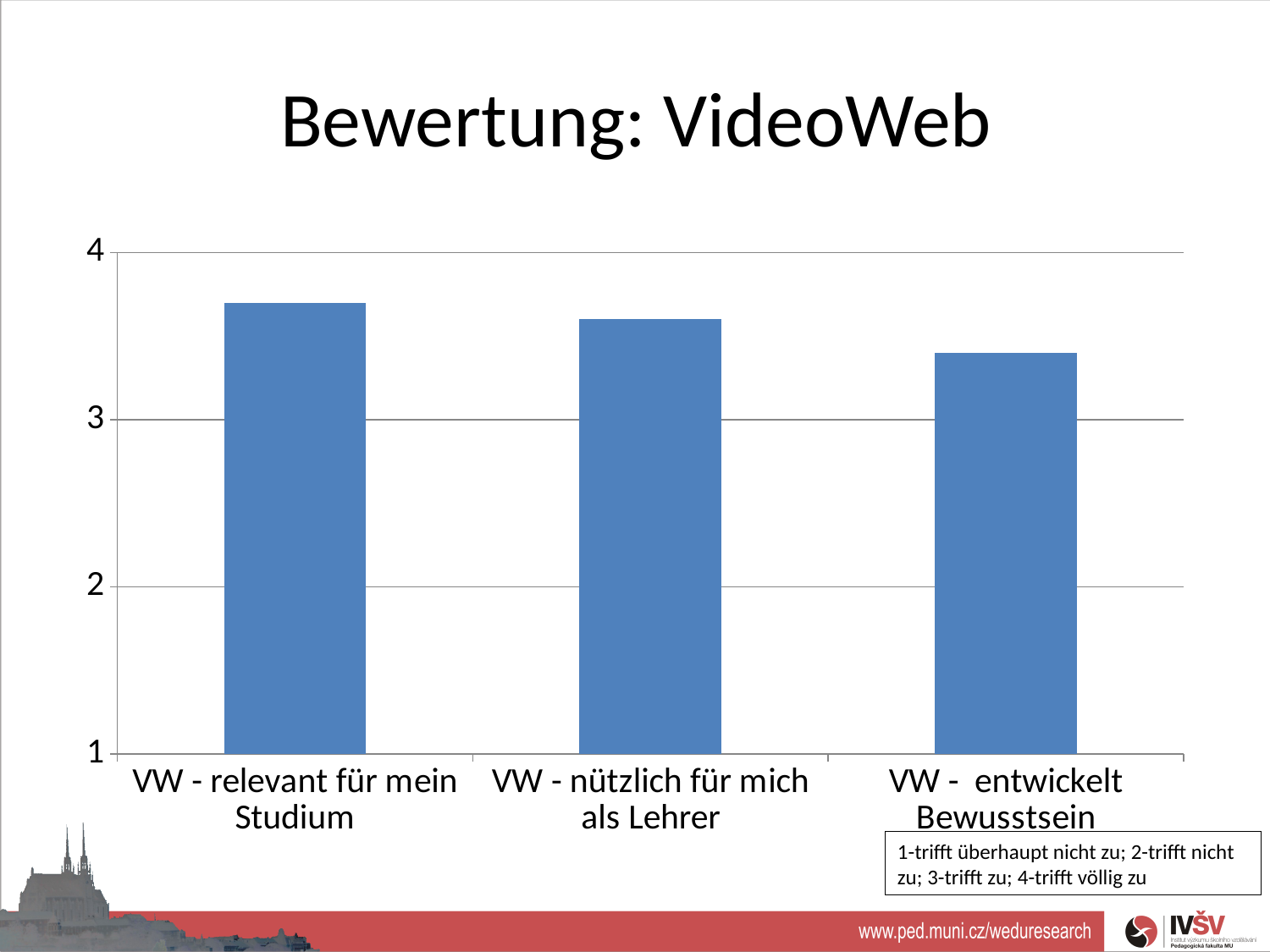
Is the value for "VW - relevant für mein Studium" greater or less than 4? less Which category has the lowest value? VW - entwickelt Bewusstsein Which is larger, the value for "VW - nützlich für mich als Lehrer" or the value for "VW - entwickelt Bewusstsein"? VW - nützlich für mich als Lehrer What kind of chart is shown on the slide? bar chart Which is larger, the value for "VW - relevant für mein Studium" or the value for "VW - entwickelt Bewusstsein"? VW - relevant für mein Studium How many categories are plotted in the chart? 3 Which category has the highest value? VW - relevant für mein Studium What is the title of the slide containing the chart? Bewertung: VideoWeb What is the lowest value shown on the vertical axis? 1 Do the values rise or fall from left to right across the categories? fall Is the value for "VW - nützlich für mich als Lehrer" greater or less than 3? greater Is the value for "VW - entwickelt Bewusstsein" greater or less than 3? greater